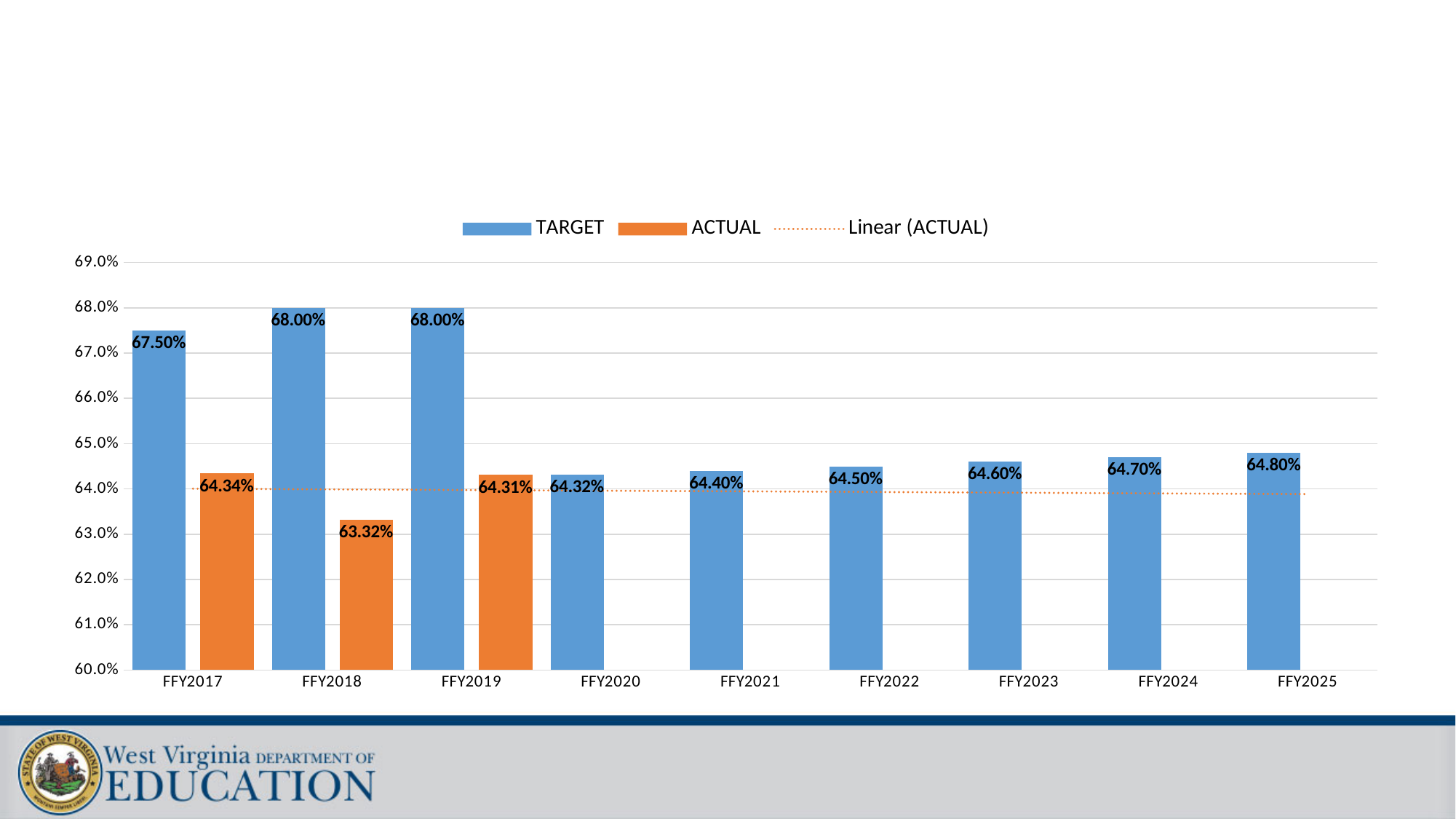
What is the ACTUAL value for FFY2018? 63.32% Which year has the lowest TARGET value? FFY2020 Which is larger, the ACTUAL value for FFY2017 or the ACTUAL value for FFY2018? FFY2017 How many years are shown on the x axis? 9 How many entries does the legend list? 3 What is the TARGET value for FFY2023? 64.60% What kind of chart is shown on the slide? Bar chart Do the TARGET values rise or fall from FFY2020 to FFY2025? Rise What is the difference between the TARGET and ACTUAL values for FFY2018? 4.68 percentage points What is the difference between the TARGET and ACTUAL values for FFY2017? 3.16 percentage points What is the TARGET value for FFY2017? 67.50% Which year has the lowest ACTUAL value? FFY2018